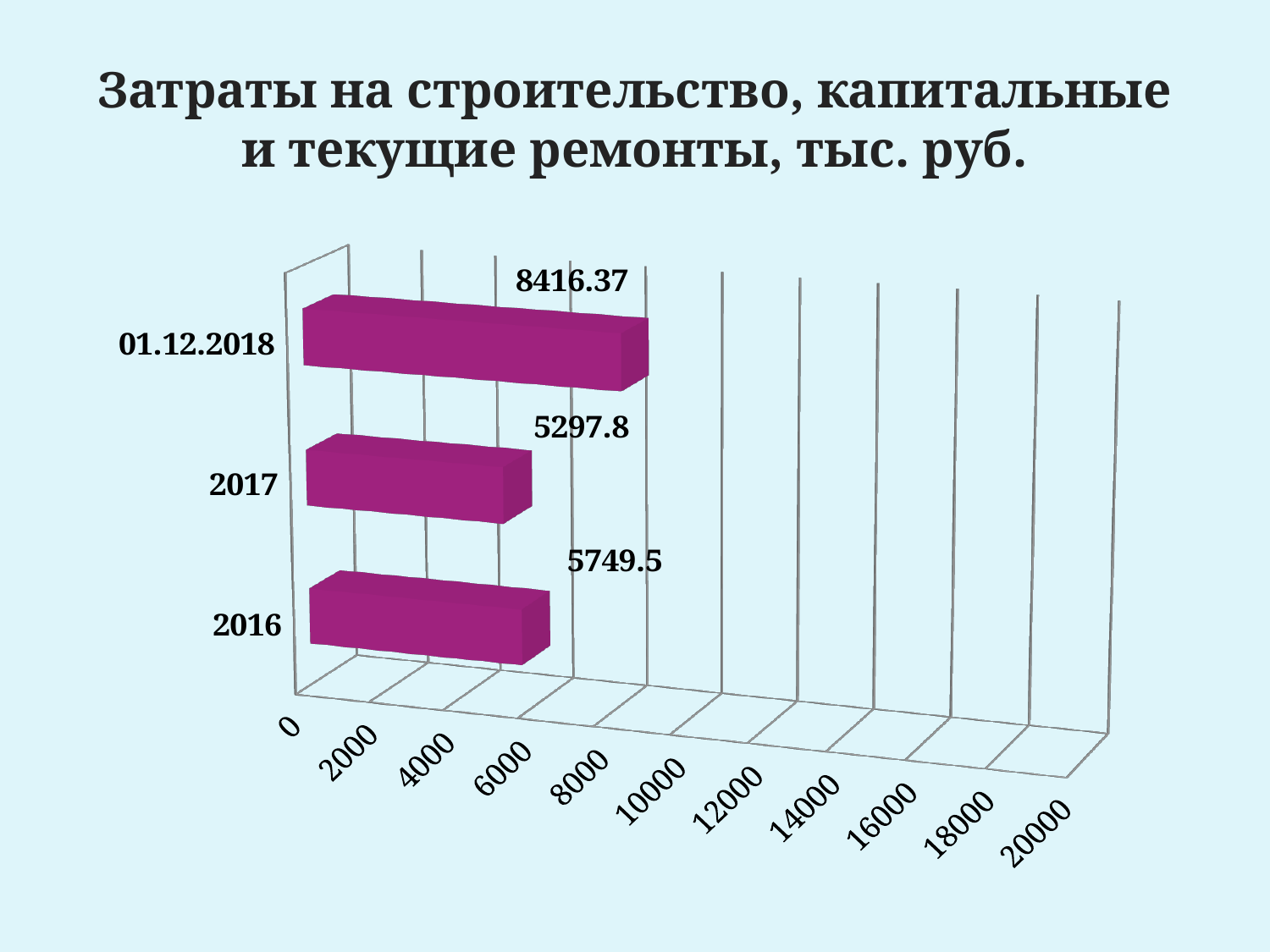
What is the difference between the values for 01.12.2018 and 2017? 3118.57 What is the value for 01.12.2018? 8416.37 What is the value for 2016? 5749.5 Is the value for 2017 greater or less than 6000? less Which is larger, the value for 2016 or the value for 2017? 2016 What kind of chart is shown on the slide? bar chart Which category has the lowest value? 2017 Which category has the highest value? 01.12.2018 How many categories are shown in the chart? 3 Did the value rise or fall from 2017 to 01.12.2018? rise What is the value for 2017? 5297.8 What is the difference between the values for 2016 and 2017? 451.7